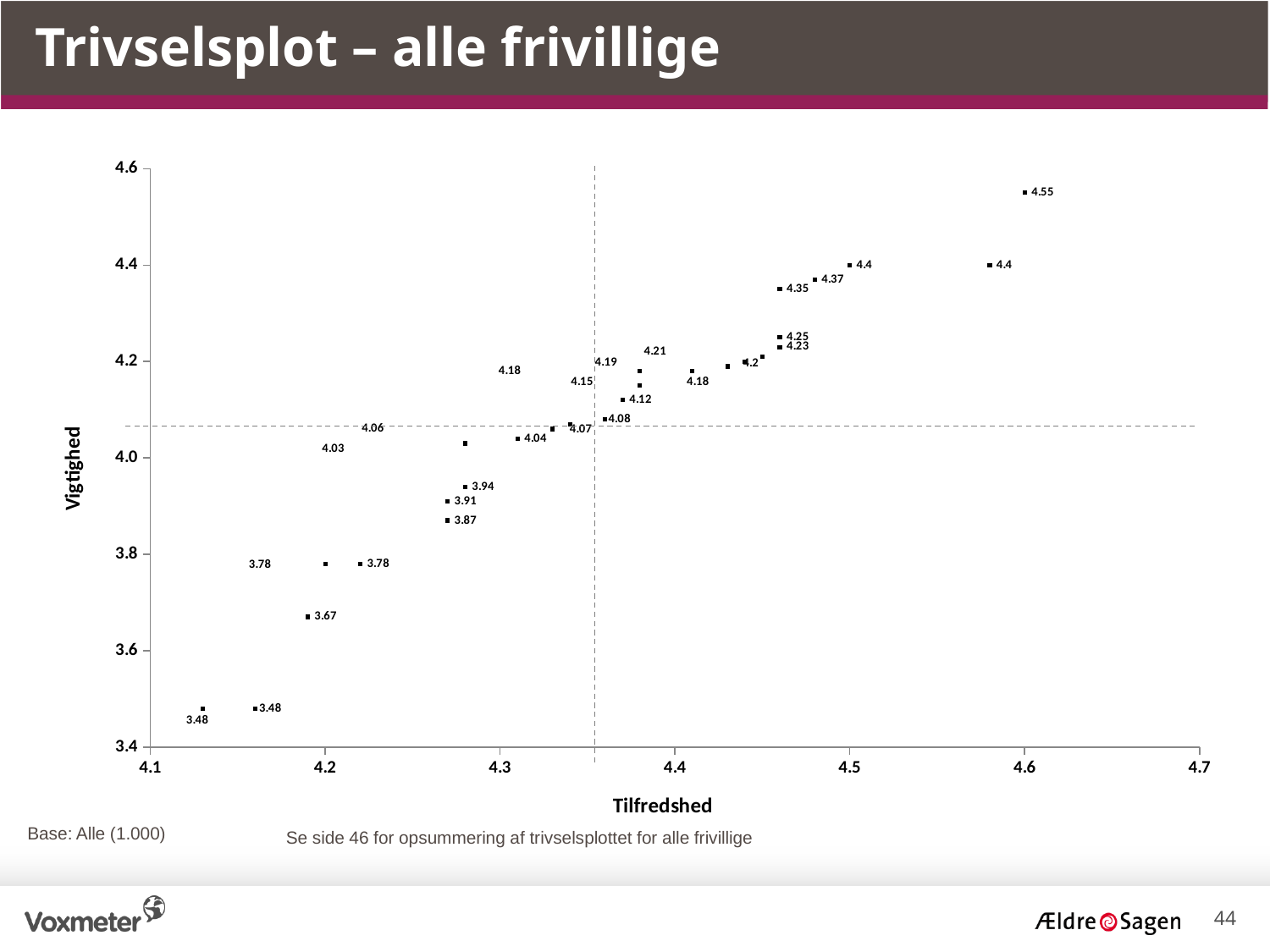
Do the Vigtighed values generally rise or fall as Tilfredshed increases along the x axis? Rise What is the difference between the highest labeled point (4.55) and the points labeled 4.4? 0.15 What is the difference between the highest labeled Vigtighed value (4.55) and the lowest labeled value (3.48)? 1.07 What is the highest Vigtighed value labeled on the chart? 4.55 Is the Tilfredshed value of the point labeled 4.55 greater or less than 4.5? greater Which point has the higher Vigtighed value, the one labeled 4.37 or the one labeled 4.35? 4.37 What kind of chart is shown on the slide? Scatter plot What is the title of the horizontal axis of the chart? Tilfredshed How many points on the chart are labeled 4.4? 2 Is the Tilfredshed value of the points labeled 3.48 greater or less than 4.2? less What is the lowest Vigtighed value labeled on the chart? 3.48 What is the title of the vertical axis of the chart? Vigtighed